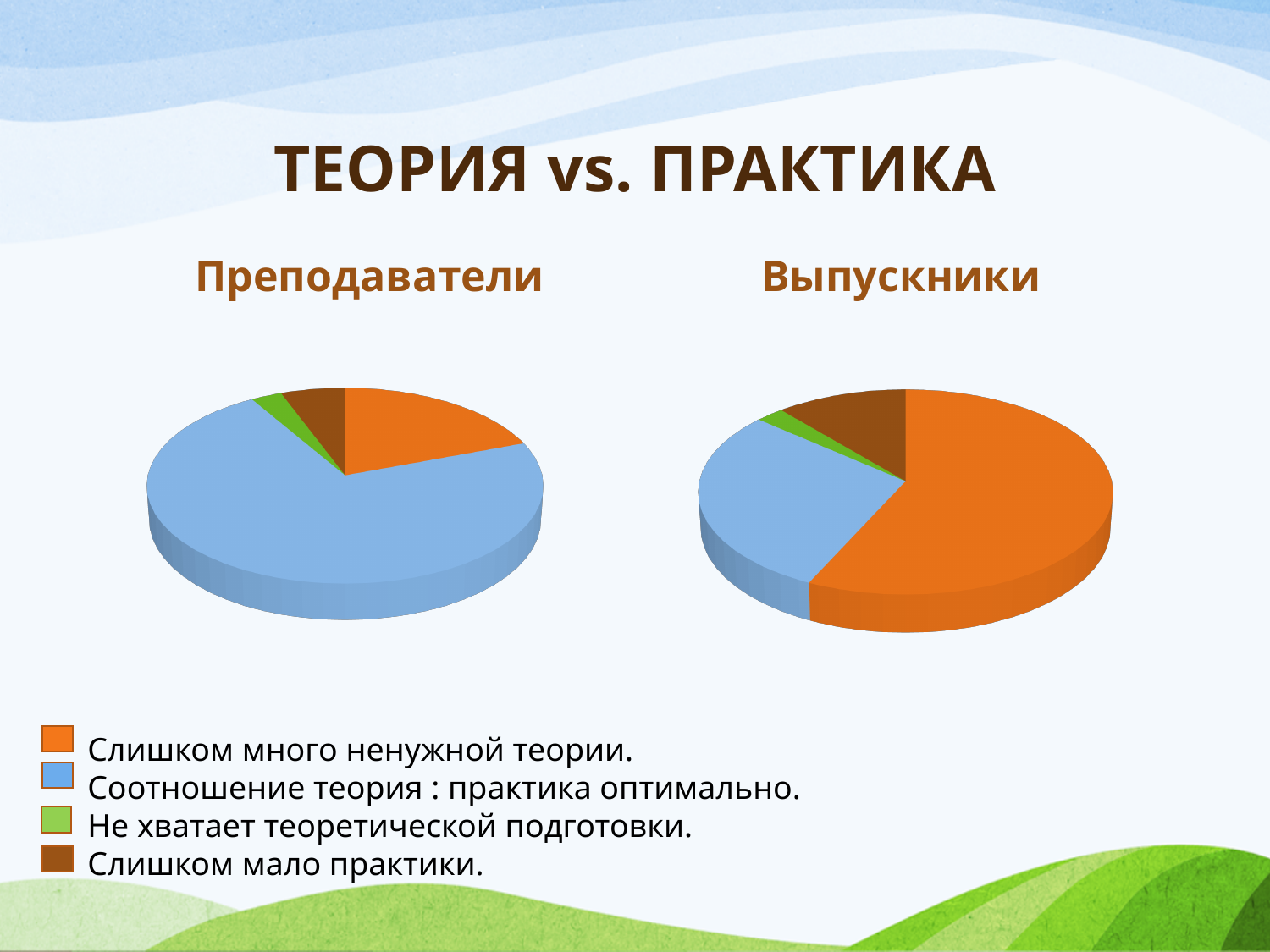
How many slices does the "Преподаватели" pie chart have? 4 What is the main title shown above the two pie charts? ТЕОРИЯ vs. ПРАКТИКА How many slices does the "Выпускники" pie chart have? 4 In the "Преподаватели" chart, which category has the smallest slice? Не хватает теоретической подготовки. How many entries does the shared legend list? 4 In the "Выпускники" chart, which category has the smallest slice? Не хватает теоретической подготовки. In the "Выпускники" chart, which slice is larger: "Соотношение теория : практика оптимально." or "Слишком мало практики."? Соотношение теория : практика оптимально. In the "Выпускники" chart, which category has the largest slice? Слишком много ненужной теории. In the "Преподаватели" chart, which slice is larger: "Слишком много ненужной теории." or "Слишком мало практики."? Слишком много ненужной теории. In the "Преподаватели" chart, which category has the largest slice? Соотношение теория : практика оптимально. What kind of chart is used for the "Выпускники" chart? pie chart What kind of chart is used for the "Преподаватели" chart? pie chart